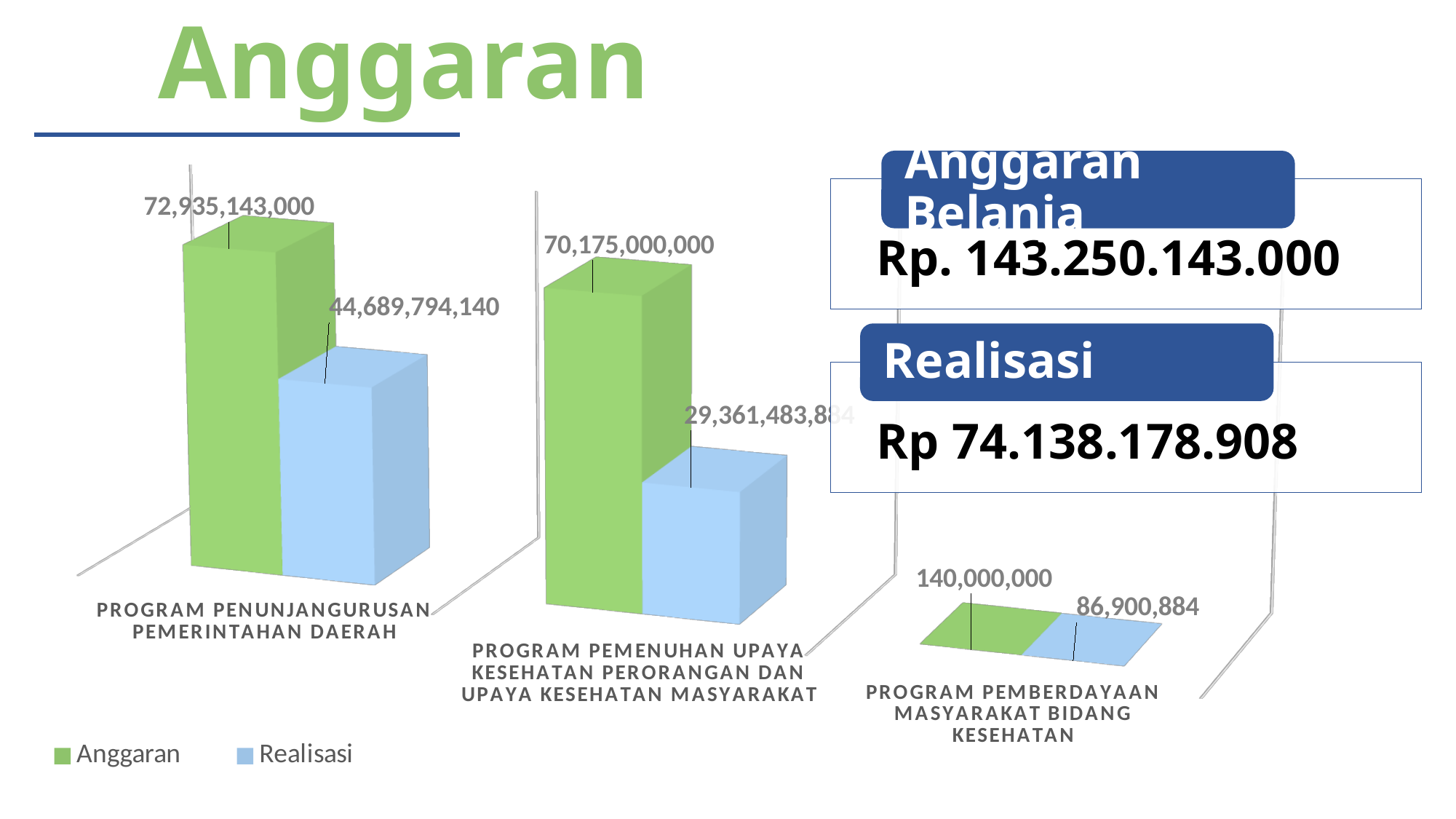
What is the Anggaran value for Program Penunjang Urusan Pemerintahan Daerah? 72,935,143,000 Which program has the highest Anggaran value? Program Penunjang Urusan Pemerintahan Daerah What is the difference between the Anggaran and Realisasi values for Program Pemberdayaan Masyarakat Bidang Kesehatan? 53,099,116 What is the Anggaran value for Program Pemenuhan Upaya Kesehatan Perorangan dan Upaya Kesehatan Masyarakat? 70,175,000,000 Which program has the lowest Realisasi value? Program Pemberdayaan Masyarakat Bidang Kesehatan What kind of chart is shown on the slide? Bar chart How many series does the legend list? 2 What is the Realisasi value for Program Pemberdayaan Masyarakat Bidang Kesehatan? 86,900,884 What is the difference between the Anggaran and Realisasi values for Program Penunjang Urusan Pemerintahan Daerah? 28,245,348,860 What is the Anggaran value for Program Pemberdayaan Masyarakat Bidang Kesehatan? 140,000,000 What is the Realisasi value for Program Penunjang Urusan Pemerintahan Daerah? 44,689,794,140 Which is larger: the Anggaran value for Program Penunjang Urusan Pemerintahan Daerah or the Anggaran value for Program Pemenuhan Upaya Kesehatan Perorangan dan Upaya Kesehatan Masyarakat? Program Penunjang Urusan Pemerintahan Daerah